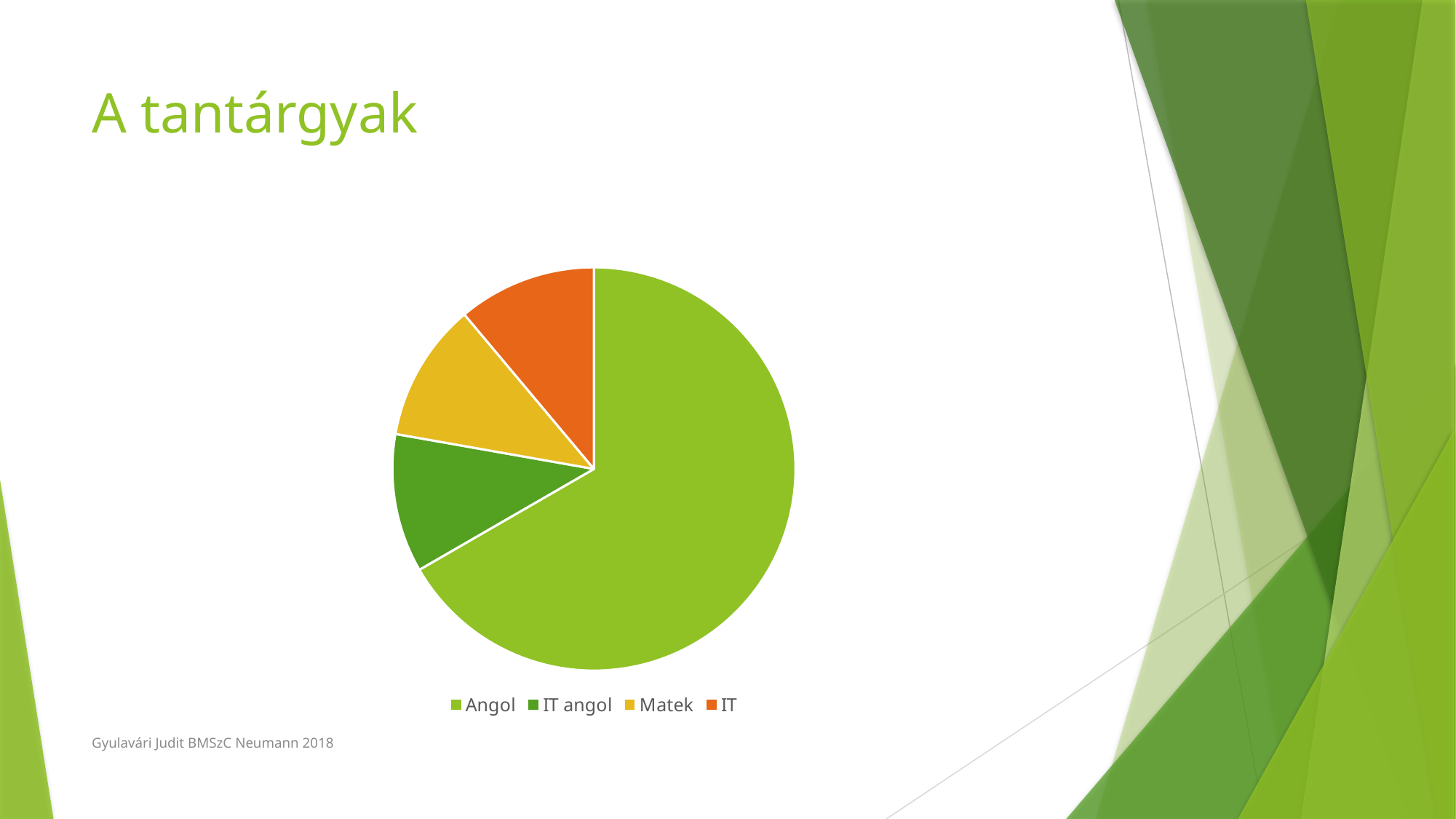
What kind of chart is shown on the slide? pie chart Does the Angol slice take up more or less than half of the pie? more Which category has the largest slice in the pie chart? Angol What is the title of the slide containing the pie chart? A tantárgyak Which slice is larger, IT or Angol? Angol Which slice is larger, Angol or IT angol? Angol How many entries does the legend of the pie chart list? 4 Which slice is larger, Angol or Matek? Angol Which category is shown in orange in the pie chart? IT How many slices does the pie chart have? 4